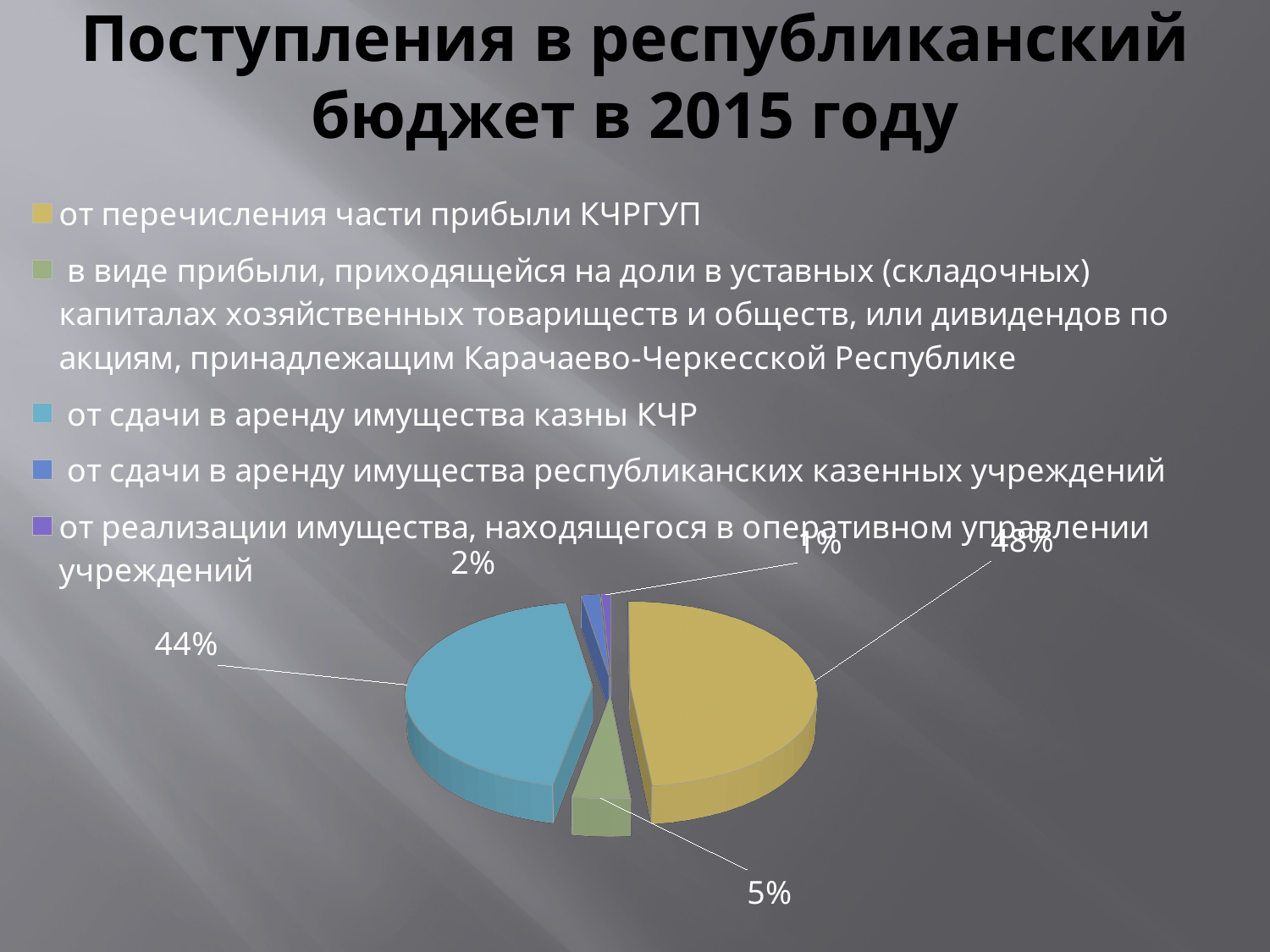
What is the difference in percentage points between the share for 'от перечисления части прибыли КЧРГУП' and the share for 'от сдачи в аренду имущества казны КЧР'? 4% What is the title of the chart on the slide? Поступления в республиканский бюджет в 2015 году What share of the pie is labelled for 'от сдачи в аренду имущества республиканских казенных учреждений'? 2% Which category has the largest share of the pie? от перечисления части прибыли КЧРГУП Which colour represents 'от сдачи в аренду имущества казны КЧР' in the pie chart? light blue What share of the pie is labelled for 'от перечисления части прибыли КЧРГУП'? 48% Which category has the smallest share of the pie? от реализации имущества, находящегося в оперативном управлении учреждений What share of the pie is labelled for 'от сдачи в аренду имущества казны КЧР'? 44% How many slices does the pie chart have? 5 What type of chart is shown on the slide? pie chart What share of the pie is labelled for 'от реализации имущества, находящегося в оперативном управлении учреждений'? 1% What share of the pie is labelled for 'в виде прибыли, приходящейся на доли в уставных (складочных) капиталах хозяйственных товариществ и обществ, или дивидендов по акциям, принадлежащим Карачаево-Черкесской Республике'? 5%